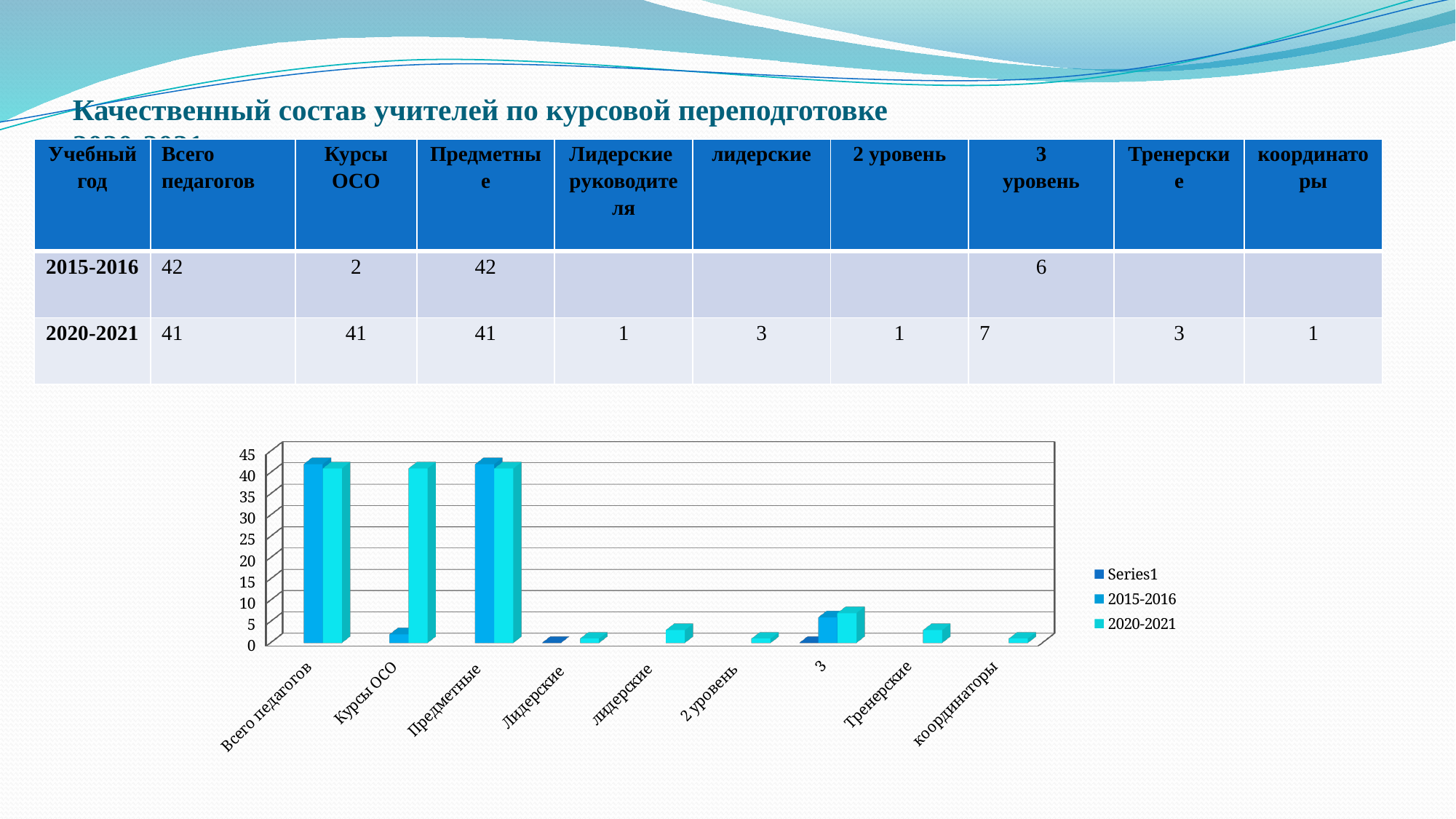
For Всего педагогов, which series has the larger value, 2015-2016 or 2020-2021? 2015-2016 Is the value for Курсы ОСО in the 2020-2021 series greater or less than 35? greater Is the value for 3 уровень in the 2020-2021 series greater or less than 10? less How many series does the chart legend list? 3 According to the table on the slide, what is the difference between the Курсы ОСО values for 2020-2021 and 2015-2016? 39 According to the table on the slide, what is the value for Курсы ОСО in 2020-2021? 41 For Курсы ОСО, which series has the larger value, 2015-2016 or 2020-2021? 2020-2021 How many categories are shown along the x axis of the chart? 9 What are the names of the series listed in the chart legend? Series1, 2015-2016, 2020-2021 Is the value for Всего педагогов in the 2015-2016 series greater or less than 40? greater What kind of chart is shown on the slide? bar chart